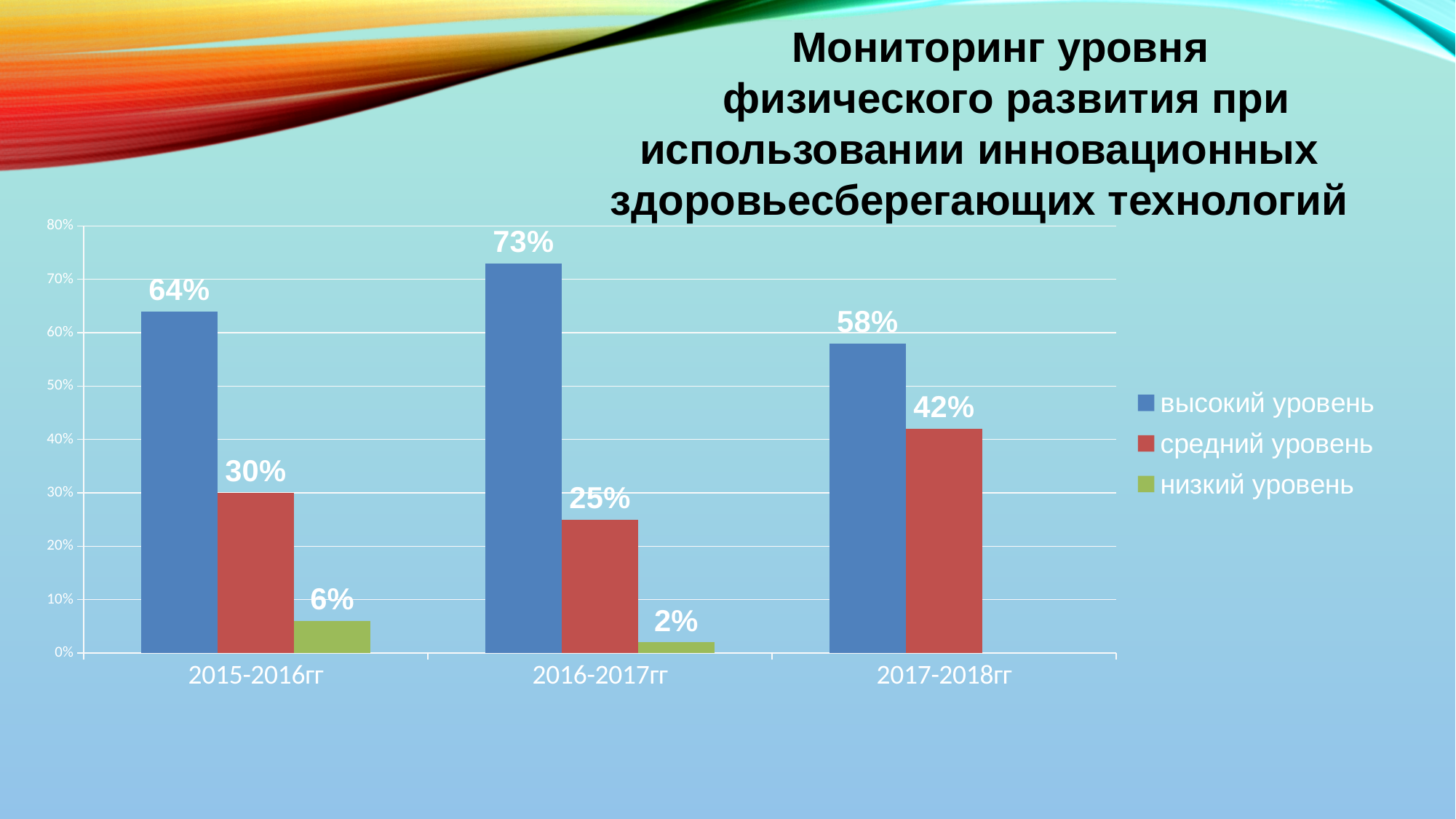
What is the difference between высокий уровень and средний уровень in 2015-2016гг? 34% What is the value for средний уровень in 2017-2018гг? 42% What kind of chart is shown on the slide? bar chart How many periods are shown on the x axis? 3 What is the value for высокий уровень in 2016-2017гг? 73% Which is larger in 2017-2018гг: высокий уровень or средний уровень? высокий уровень In which period is the value for высокий уровень the highest? 2016-2017гг In which period is the value for средний уровень the lowest? 2016-2017гг How many series does the legend list? 3 What colour represents низкий уровень in the legend? green Does the value for средний уровень rise or fall from 2016-2017гг to 2017-2018гг? rise What is the value for низкий уровень in 2015-2016гг? 6%